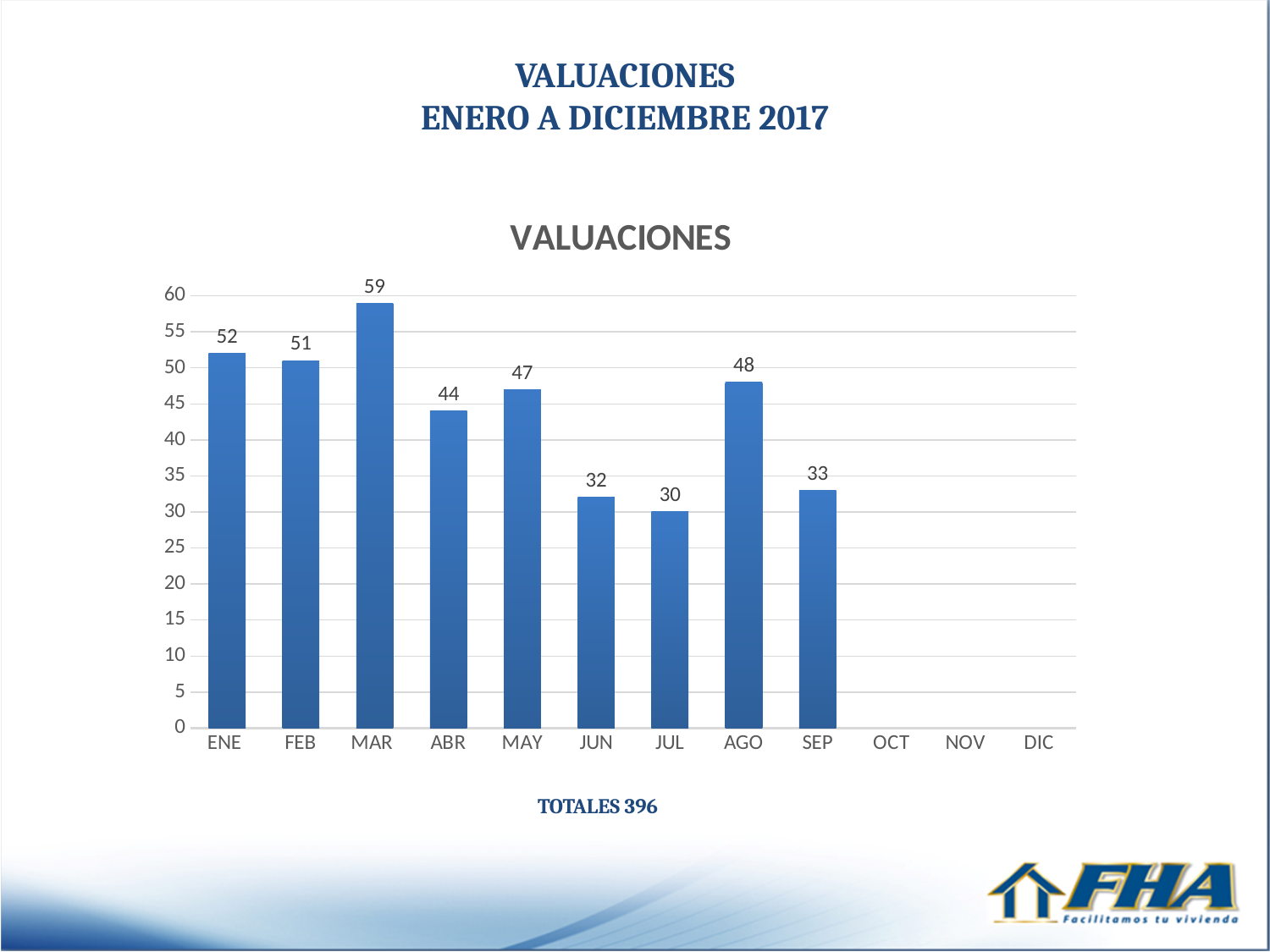
Which month has the highest value? MAR Which month with a plotted bar has the lowest value? JUL Is the value for SEP greater or less than 40? less What is the value for AGO? 48 What is the difference between the values for MAR and ABR? 15 Which is larger, the value for ENE or the value for MAY? ENE What is the title of the chart? VALUACIONES What is the value for JUL? 30 How many months have a plotted bar in the chart? 9 What kind of chart is shown? bar chart What is the value for MAR? 59 How many category labels are shown on the x axis? 12